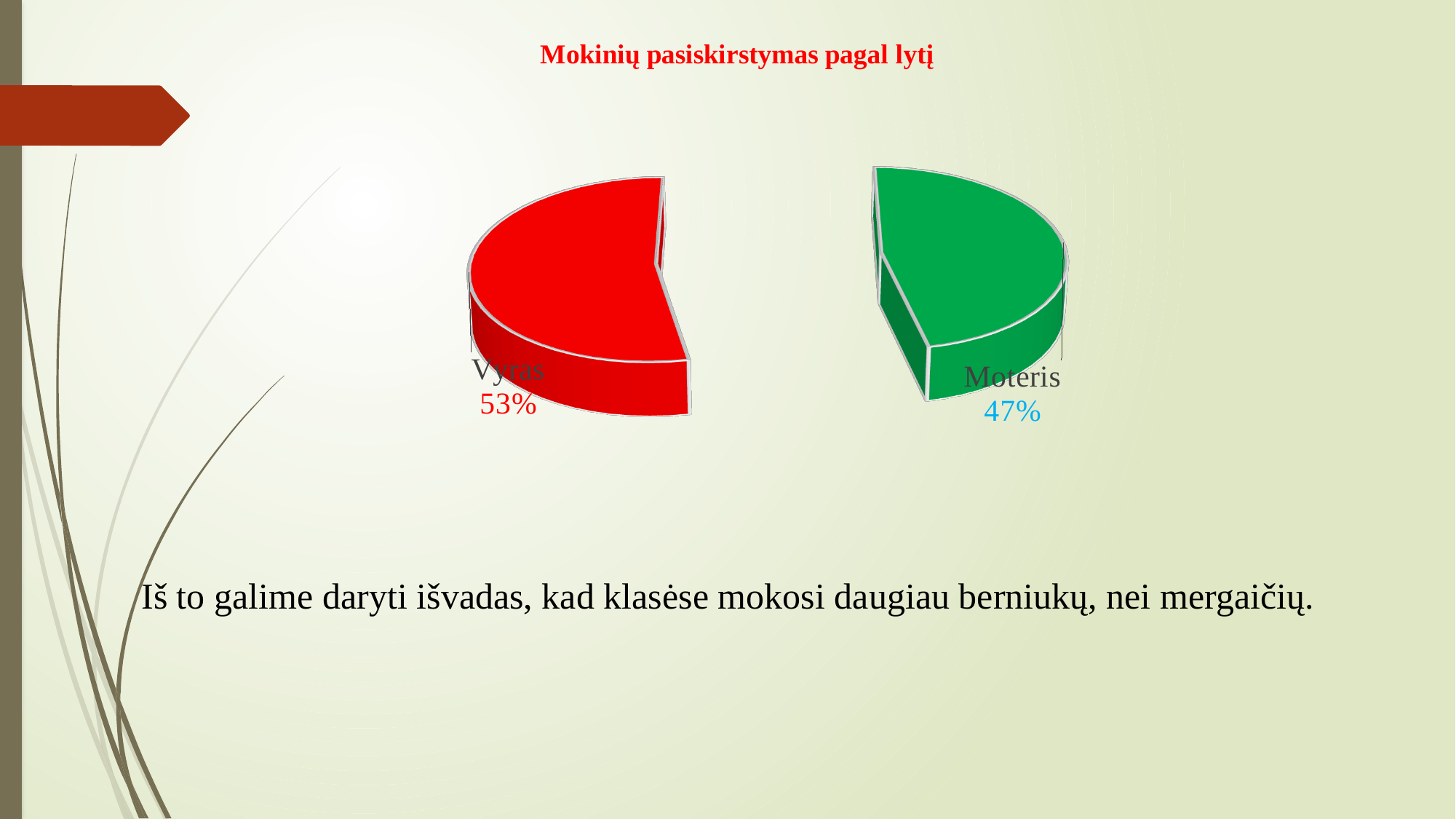
What is the difference in percentage points between Vyras and Moteris? 6% What share of the pie does Vyras have? 53% What is the title of the chart? Mokinių pasiskirstymas pagal lytį Which is larger, the share for Vyras or the share for Moteris? Vyras What kind of chart is shown on the slide? Pie chart Is the share for Vyras greater or less than 50%? greater Is the share for Moteris greater or less than 50%? less How many categories does the pie chart show? 2 Which category has the largest slice? Vyras What colour is the Moteris slice? Green What share of the pie does Moteris have? 47% Which category has the smallest slice? Moteris